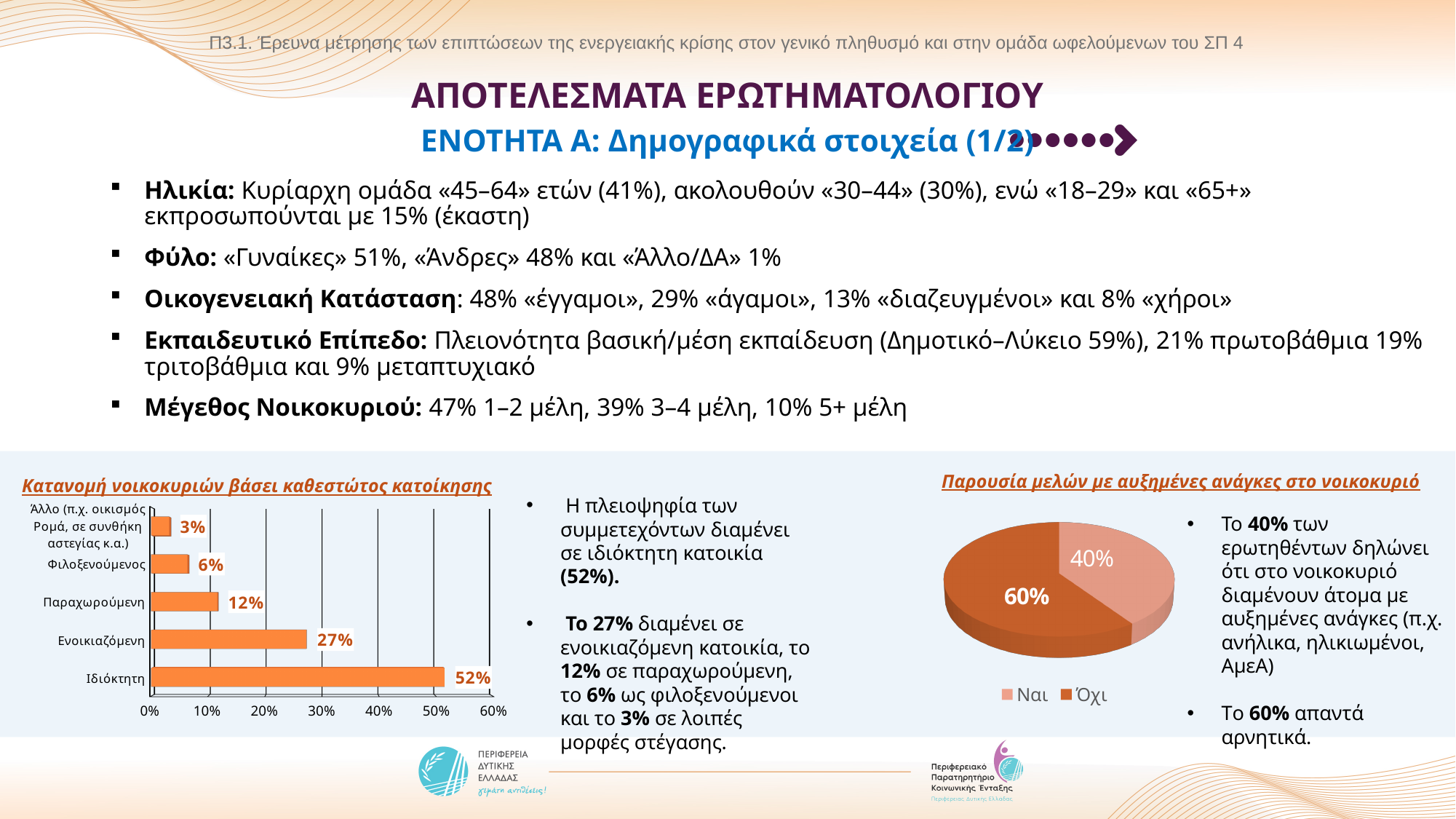
In the bar chart 'Κατανομή νοικοκυριών βάσει καθεστώτος κατοίκησης', which category has the highest value? Ιδιόκτητη In the bar chart 'Κατανομή νοικοκυριών βάσει καθεστώτος κατοίκησης', which is larger: 'Φιλοξενούμενος' or 'Παραχωρούμενη'? Παραχωρούμενη In the bar chart 'Κατανομή νοικοκυριών βάσει καθεστώτος κατοίκησης', what is the value for 'Παραχωρούμενη'? 12% In the bar chart 'Κατανομή νοικοκυριών βάσει καθεστώτος κατοίκησης', what is the difference between 'Ιδιόκτητη' and 'Ενοικιαζόμενη'? 25% In the pie chart 'Παρουσία μελών με αυξημένες ανάγκες στο νοικοκυριό', what share does 'Όχι' have? 60% How many entries does the legend of the pie chart 'Παρουσία μελών με αυξημένες ανάγκες στο νοικοκυριό' list? 2 In the bar chart 'Κατανομή νοικοκυριών βάσει καθεστώτος κατοίκησης', what is the value for 'Ενοικιαζόμενη'? 27% In the pie chart 'Παρουσία μελών με αυξημένες ανάγκες στο νοικοκυριό', what share does 'Ναι' have? 40% How many categories does the bar chart 'Κατανομή νοικοκυριών βάσει καθεστώτος κατοίκησης' show? 5 In the bar chart 'Κατανομή νοικοκυριών βάσει καθεστώτος κατοίκησης', what is the value for 'Ιδιόκτητη'? 52% In the bar chart 'Κατανομή νοικοκυριών βάσει καθεστώτος κατοίκησης', which category has the lowest value? Άλλο (π.χ. οικισμός Ρομά, σε συνθήκη αστεγίας κ.α.) What type of chart is 'Κατανομή νοικοκυριών βάσει καθεστώτος κατοίκησης'? Bar chart